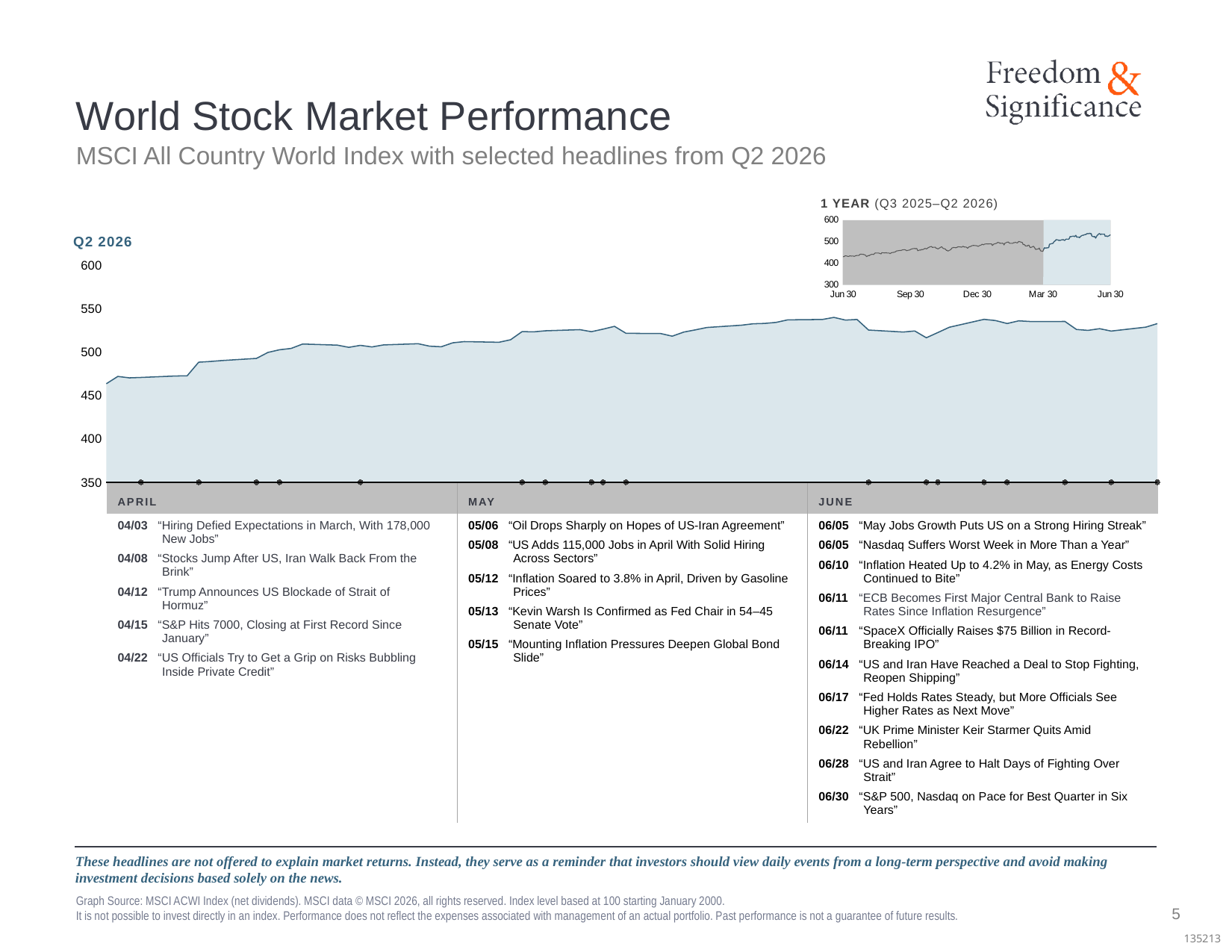
On the Q2 2026 chart, does the index level generally rise or fall from the start of April to the end of June? Rise On the Q2 2026 chart, is the index level at the start of April greater or less than 450? greater On the 1 YEAR inset chart, does the index level rise or fall from Jun 30 to the following Jun 30? Rise What period does the 1 YEAR inset chart cover, according to its title? Q3 2025–Q2 2026 On the Q2 2026 chart, is the index level at the end of June greater or less than 550? less On the Q2 2026 chart, is the index level at the end of June greater or less than 500? greater On the Q2 2026 chart, what is the lowest value shown on the vertical axis? 350 On the Q2 2026 chart, what kind of chart is used to show the MSCI All Country World Index? Line chart (area chart) On the 1 YEAR inset chart, how many date labels are shown on the horizontal axis? 5